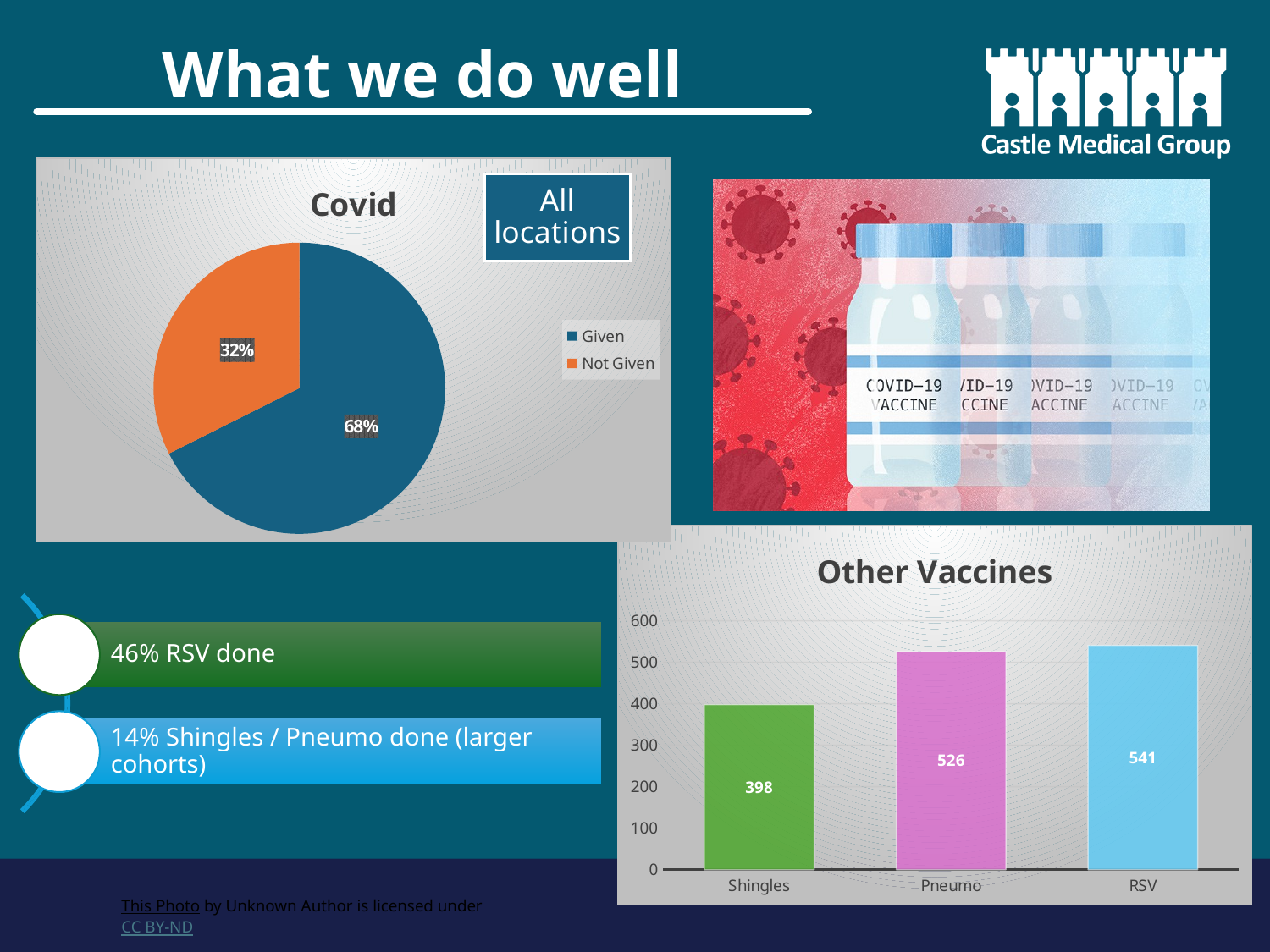
In the Other Vaccines chart, which category has the highest value? RSV How many entries does the legend of the Covid pie chart list? 2 What kind of chart is the Other Vaccines chart? Bar chart In the Other Vaccines chart, what is the value for Pneumo? 526 How many categories are shown in the Other Vaccines chart? 3 In the Covid pie chart, which slice is larger, Given or Not Given? Given In the Covid pie chart, what percentage is shown for Given? 68% In the Other Vaccines chart, which category has the lowest value? Shingles In the Other Vaccines chart, what is the value for Shingles? 398 In the Other Vaccines chart, what is the difference between the values for RSV and Shingles? 143 What kind of chart is the Covid chart? Pie chart In the Covid pie chart, what percentage is shown for Not Given? 32%